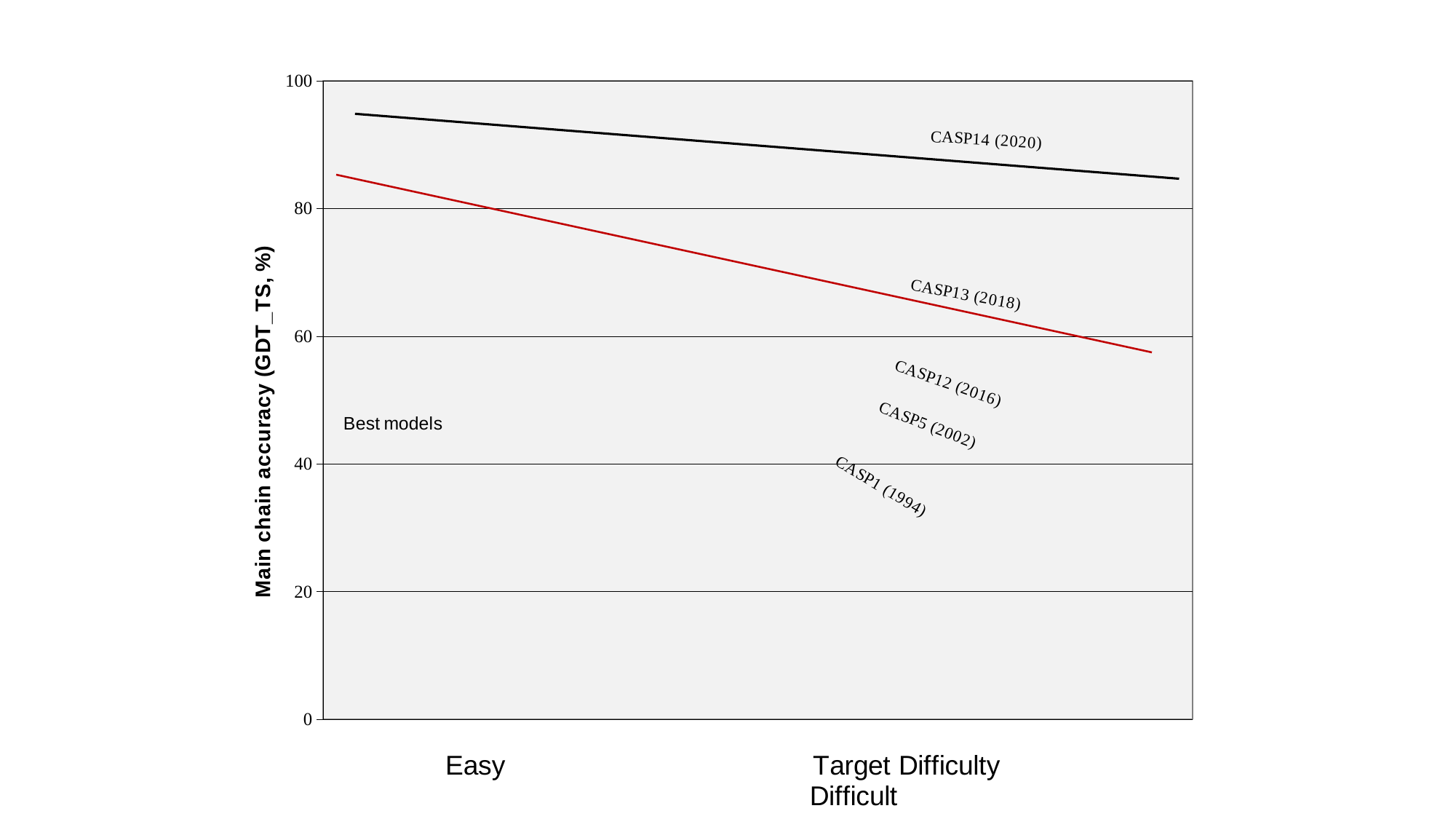
What colour is the CASP13 (2018) line? red Is the value of the CASP13 (2018) line at the Difficult end greater or less than 60? less At the Difficult end of the x axis, which line is higher: CASP14 (2020) or CASP13 (2018)? CASP14 (2020) Is the value of the CASP13 (2018) line at the Easy end greater or less than 80? greater How many lines are actually plotted on the chart? 2 Does the CASP14 (2020) line rise or fall as target difficulty goes from Easy to Difficult? fall Is the value of the CASP14 (2020) line at the Difficult end greater or less than 80? greater Which of the two plotted lines falls more steeply from Easy to Difficult? CASP13 (2018) What kind of chart is shown on the slide? line chart Does the CASP13 (2018) line rise or fall as target difficulty goes from Easy to Difficult? fall What is the label of the y axis? Main chain accuracy (GDT_TS, %)